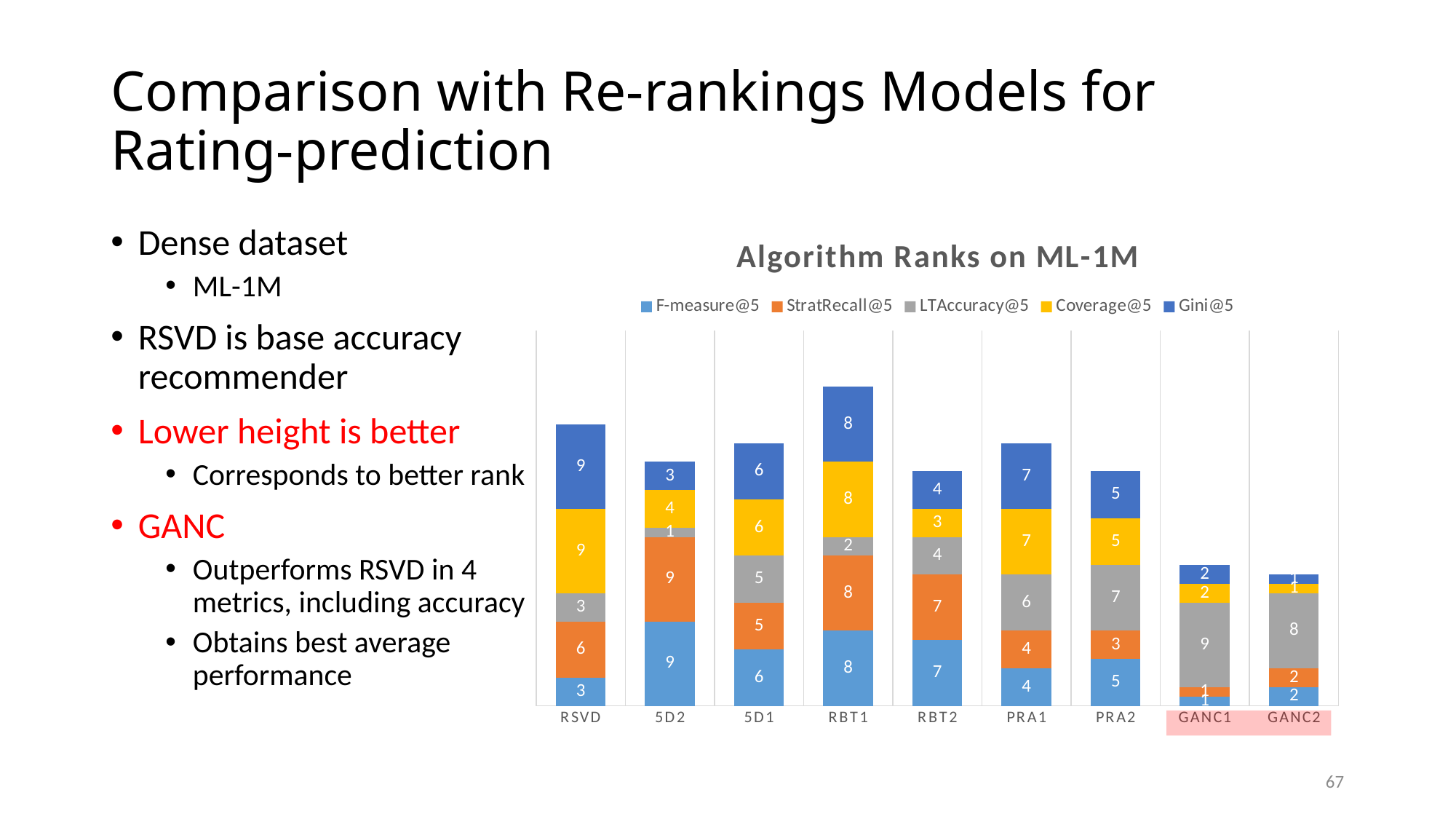
What is the total stacked rank for GANC2? 14 What is the LTAccuracy@5 rank for GANC1? 9 What is the Coverage@5 rank for PRA1? 7 What type of chart is shown on the slide? Stacked bar chart What is the total stacked rank for RBT1? 34 What is the Gini@5 rank for RSVD? 9 What is the F-measure@5 rank for 5D2? 9 What is the difference between the StratRecall@5 rank for 5D2 and for RSVD? 3 What is the title of the chart? Algorithm Ranks on ML-1M How many series does the chart legend list? 5 Which algorithm has the tallest stacked bar? RBT1 How many algorithms (categories) are shown on the x axis? 9